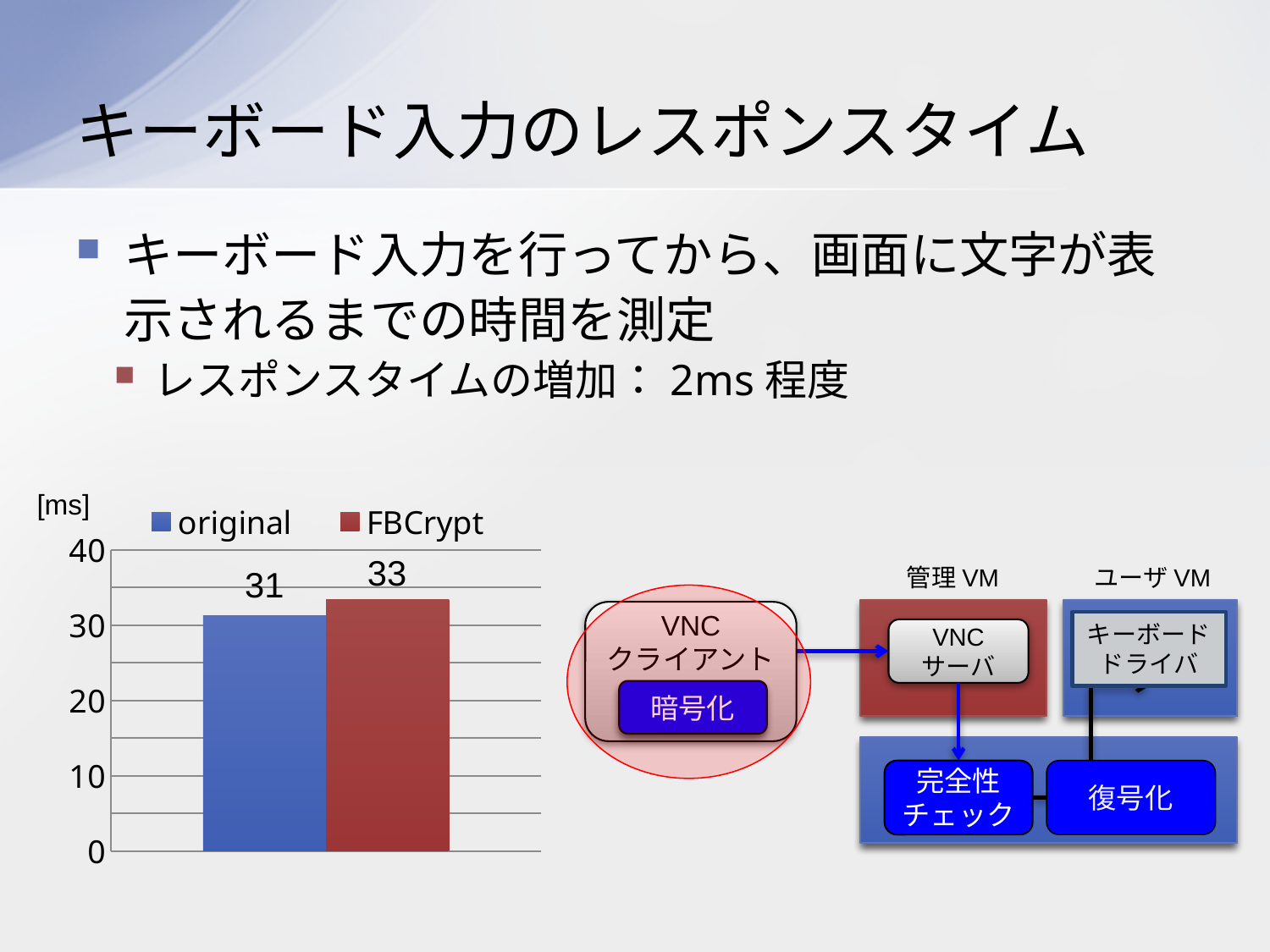
Is the value for original greater or less than 30? greater What unit is shown on the chart's vertical axis? ms What is the value for FBCrypt? 33 Which series has the higher value, original or FBCrypt? FBCrypt How many bars are plotted in the chart? 2 How many series does the legend list? 2 Which series has the lowest value? original What is the value for original? 31 Is the value for FBCrypt greater or less than 40? less What kind of chart is shown on the slide? bar chart What colour is the FBCrypt bar? red What is the difference between the FBCrypt value and the original value? 2